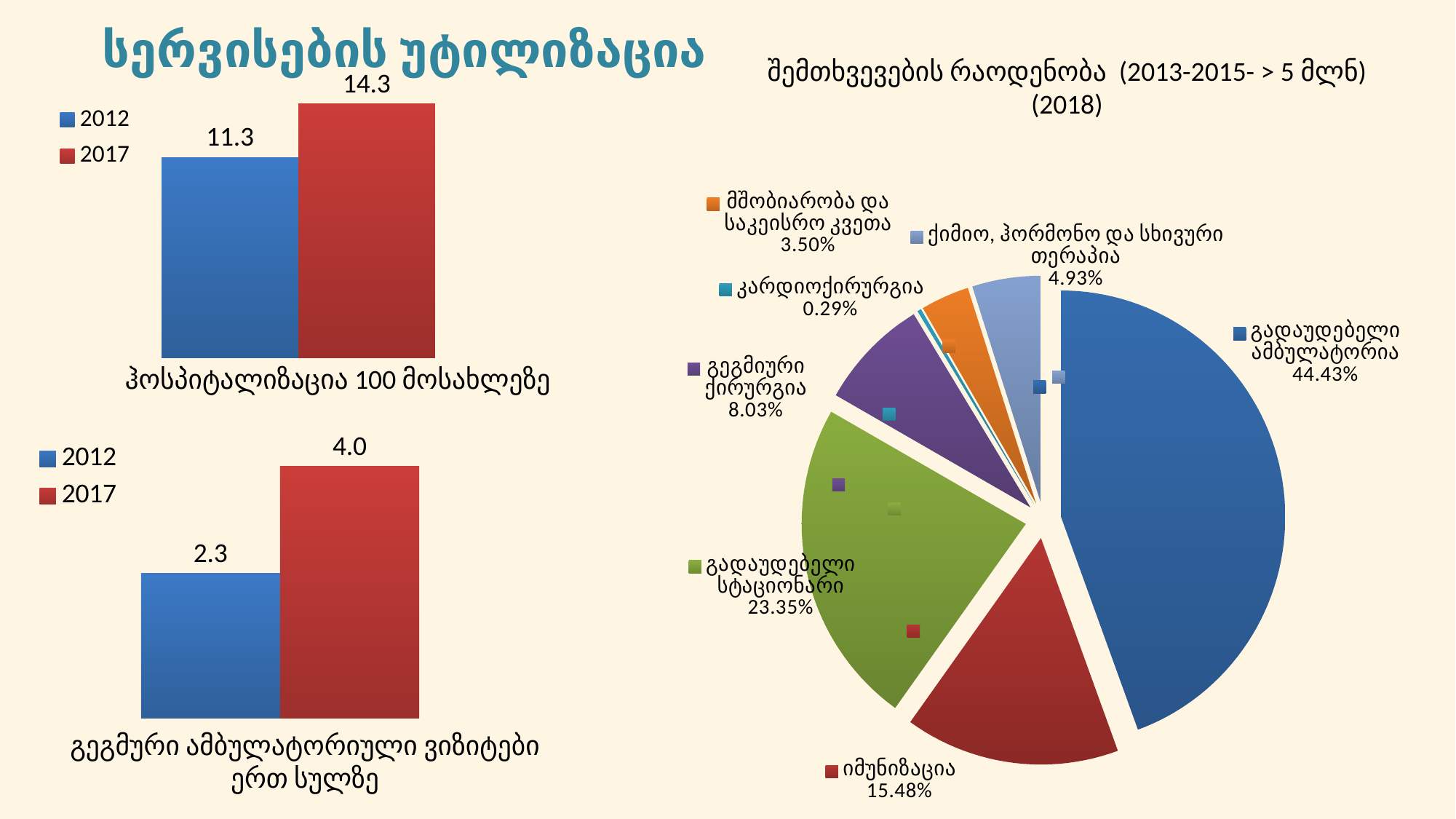
In the pie chart on the right, which category has the smallest share? კარდიოქირურგია How many series does the legend of the top-left bar chart list? 2 In the bottom-left bar chart (გეგმური ამბულატორიული ვიზიტები ერთ სულზე), what is the difference between the 2017 and 2012 values? 1.7 In the top-left bar chart (ჰოსპიტალიზაცია 100 მოსახლეზე), what is the value for 2017? 14.3 In the top-left bar chart (ჰოსპიტალიზაცია 100 მოსახლეზე), what is the value for 2012? 11.3 In the pie chart on the right, what is the share for იმუნიზაცია? 15.48% In the bottom-left bar chart (გეგმური ამბულატორიული ვიზიტები ერთ სულზე), which year has the higher value, 2012 or 2017? 2017 In the bottom-left bar chart (გეგმური ამბულატორიული ვიზიტები ერთ სულზე), what is the value for 2012? 2.3 In the top-left bar chart (ჰოსპიტალიზაცია 100 მოსახლეზე), what is the difference between the 2017 and 2012 values? 3.0 How many slices does the pie chart on the right have? 7 In the pie chart on the right, what share does გადაუდებელი ამბულატორია have? 44.43% What kind of chart is the chart on the right side of the slide? Pie chart